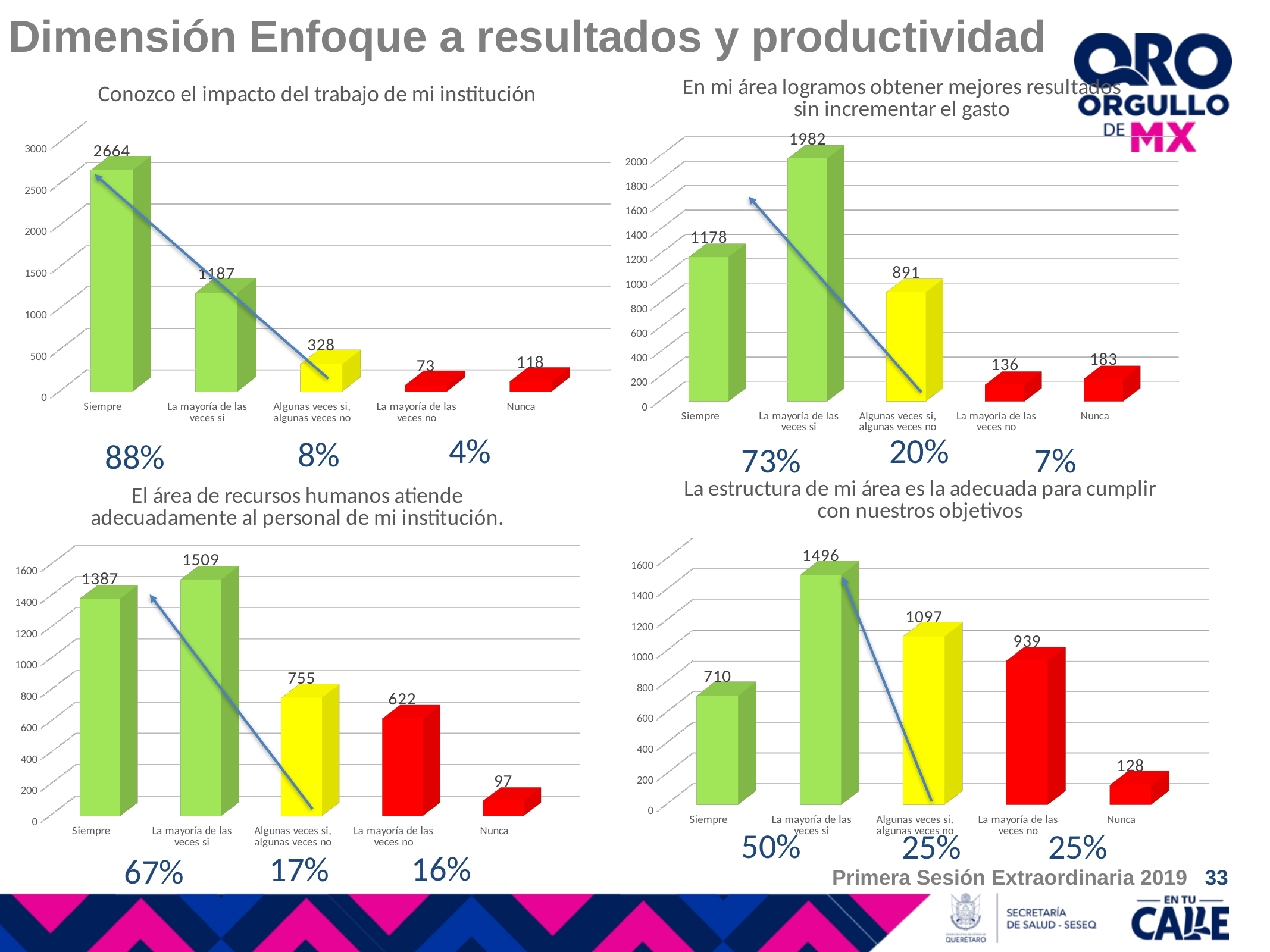
In the chart titled "El área de recursos humanos atiende adecuadamente al personal de mi institución", how many categories are shown on the x axis? 5 In the chart titled "Conozco el impacto del trabajo de mi institución", which category has the lowest value? La mayoría de las veces no In the chart titled "La estructura de mi área es la adecuada para cumplir con nuestros objetivos", which category has the lowest value? Nunca In the chart titled "En mi área logramos obtener mejores resultados sin incrementar el gasto", which is larger: La mayoría de las veces no or Nunca? Nunca In the chart titled "El área de recursos humanos atiende adecuadamente al personal de mi institución", what is the difference between La mayoría de las veces si and Siempre? 122 In the chart titled "En mi área logramos obtener mejores resultados sin incrementar el gasto", what is the value for Algunas veces si, algunas veces no? 891 In the chart titled "Conozco el impacto del trabajo de mi institución", what is the difference between Siempre and La mayoría de las veces si? 1477 In the chart titled "Conozco el impacto del trabajo de mi institución", what is the value for Siempre? 2664 In the chart titled "La estructura de mi área es la adecuada para cumplir con nuestros objetivos", what is the value for Siempre? 710 In the chart titled "En mi área logramos obtener mejores resultados sin incrementar el gasto", which category has the highest value? La mayoría de las veces si What kind of chart is the one titled "La estructura de mi área es la adecuada para cumplir con nuestros objetivos"? Bar chart In the chart titled "El área de recursos humanos atiende adecuadamente al personal de mi institución", what is the value for La mayoría de las veces no? 622